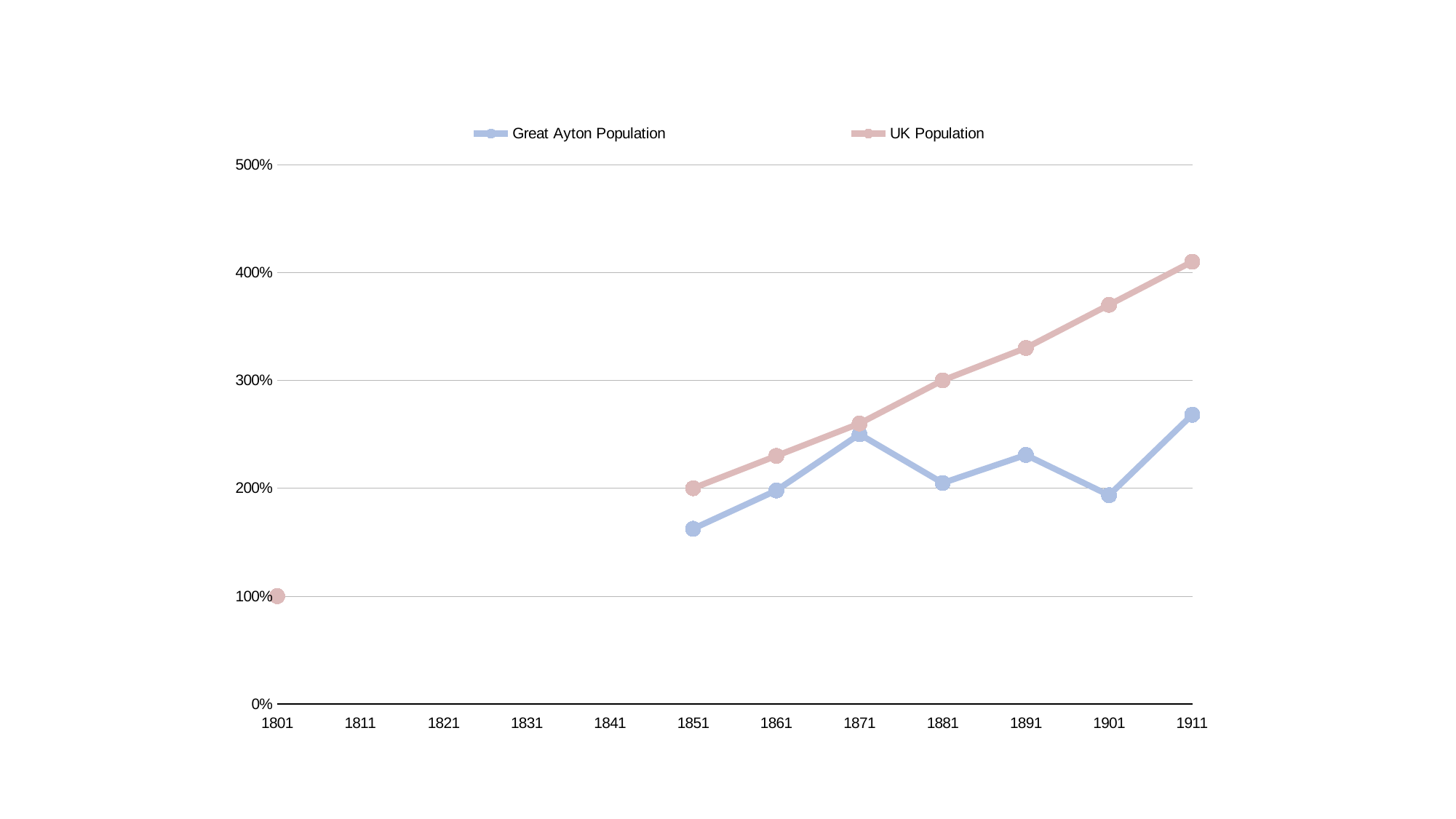
In which year does the Great Ayton Population series reach its highest value? 1911 How many series does the legend list? 2 In 1911, which series has the larger value, Great Ayton Population or UK Population? UK Population Does the UK Population series rise or fall from 1851 to 1911? rise What kind of chart is shown on the slide? line chart What is the value for UK Population in 1881? 300% Is the value for Great Ayton Population in 1911 greater or less than 300%? less Is the value for UK Population in 1911 greater or less than 400%? greater What are the two series named in the legend? Great Ayton Population and UK Population What is the value for UK Population in 1851? 200% How many year labels are shown on the x axis? 12 Is the value for Great Ayton Population in 1851 greater or less than 200%? less